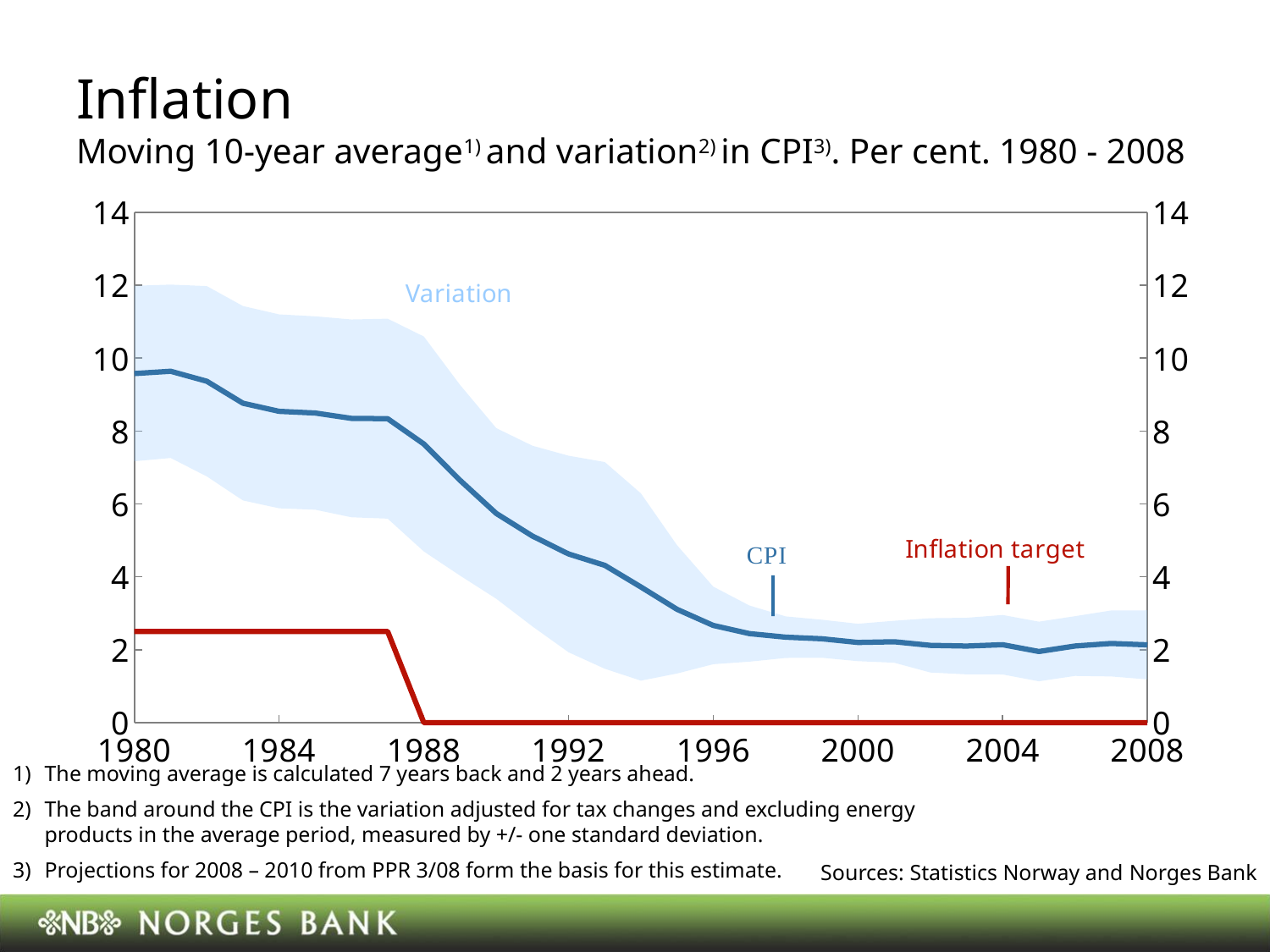
Is the CPI value in 2000 greater or less than 4? less What is the value of the Inflation target line in 2000? 0 Is the Inflation target value in 1984 greater or less than 2? greater What kind of chart is shown on the slide? combination area and line chart (lines with a shaded band) What is the highest value shown on the y axis? 14 Which is larger, the CPI value in 1980 or the CPI value in 2008? 1980 Which is larger in 1984, the CPI value or the Inflation target value? CPI What is the title of the chart on the slide? Inflation Is the CPI value in 1980 greater or less than 8? greater Which three series are labelled on the chart? Variation, CPI, Inflation target Does the CPI line rise or fall from 1980 to 2008? fall